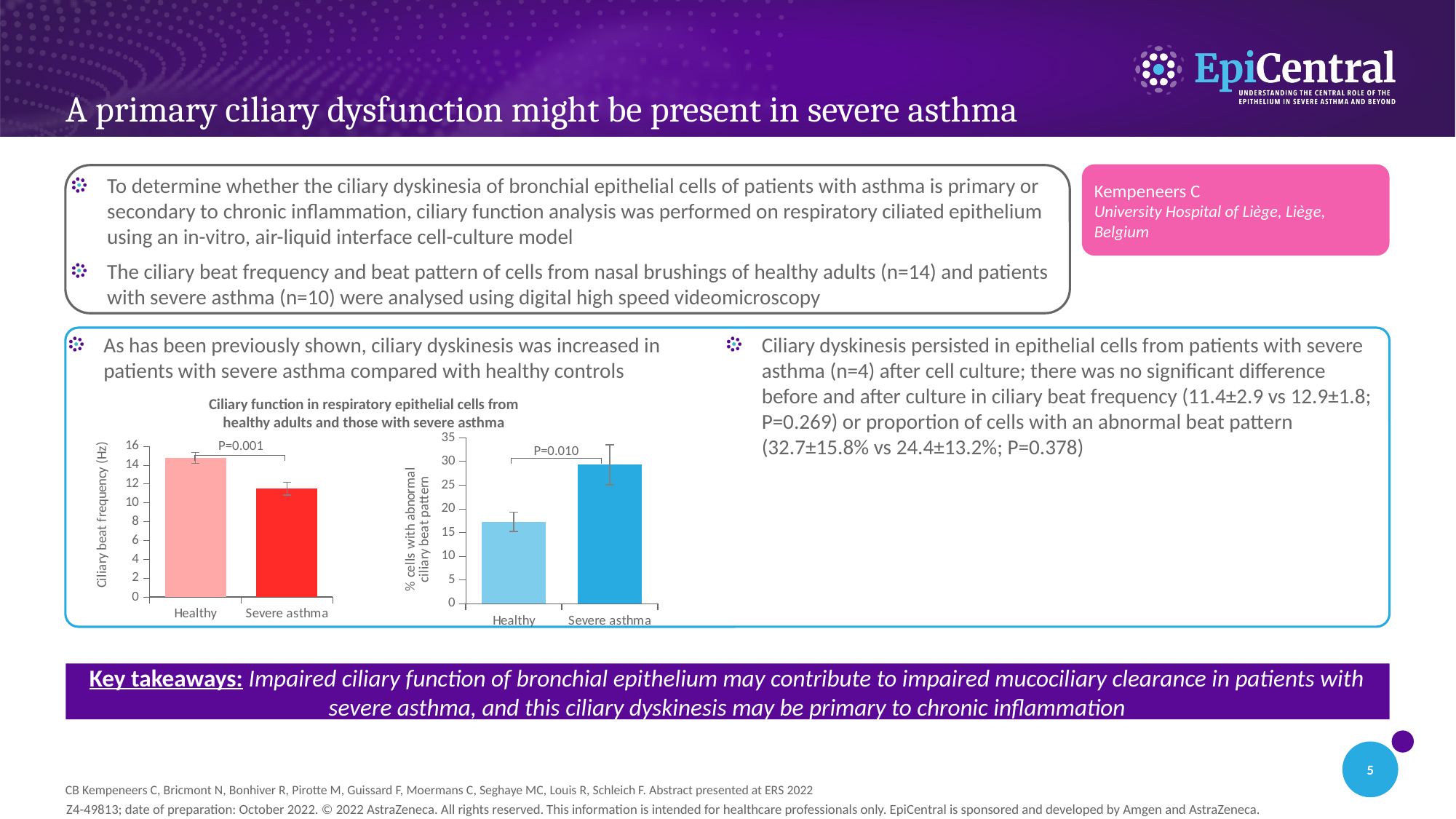
What P value is shown above the bars in the left chart (Ciliary beat frequency)? P=0.001 In the left chart (Ciliary beat frequency), is the value for Healthy greater or less than 14? greater In the right chart (% cells with abnormal ciliary beat pattern), is the value for Healthy greater or less than 20? less How many categories are shown on the x axis of the left chart (Ciliary beat frequency)? 2 In the right chart (% cells with abnormal ciliary beat pattern), is the value for Healthy greater or less than 15? greater In the left chart (Ciliary beat frequency), which category has the lower bar? Severe asthma What kind of chart is the right chart (% cells with abnormal ciliary beat pattern)? bar chart In the left chart (Ciliary beat frequency), which category has the higher bar? Healthy In the right chart (% cells with abnormal ciliary beat pattern), which category has the higher bar? Severe asthma What P value is shown above the bars in the right chart (% cells with abnormal ciliary beat pattern)? P=0.010